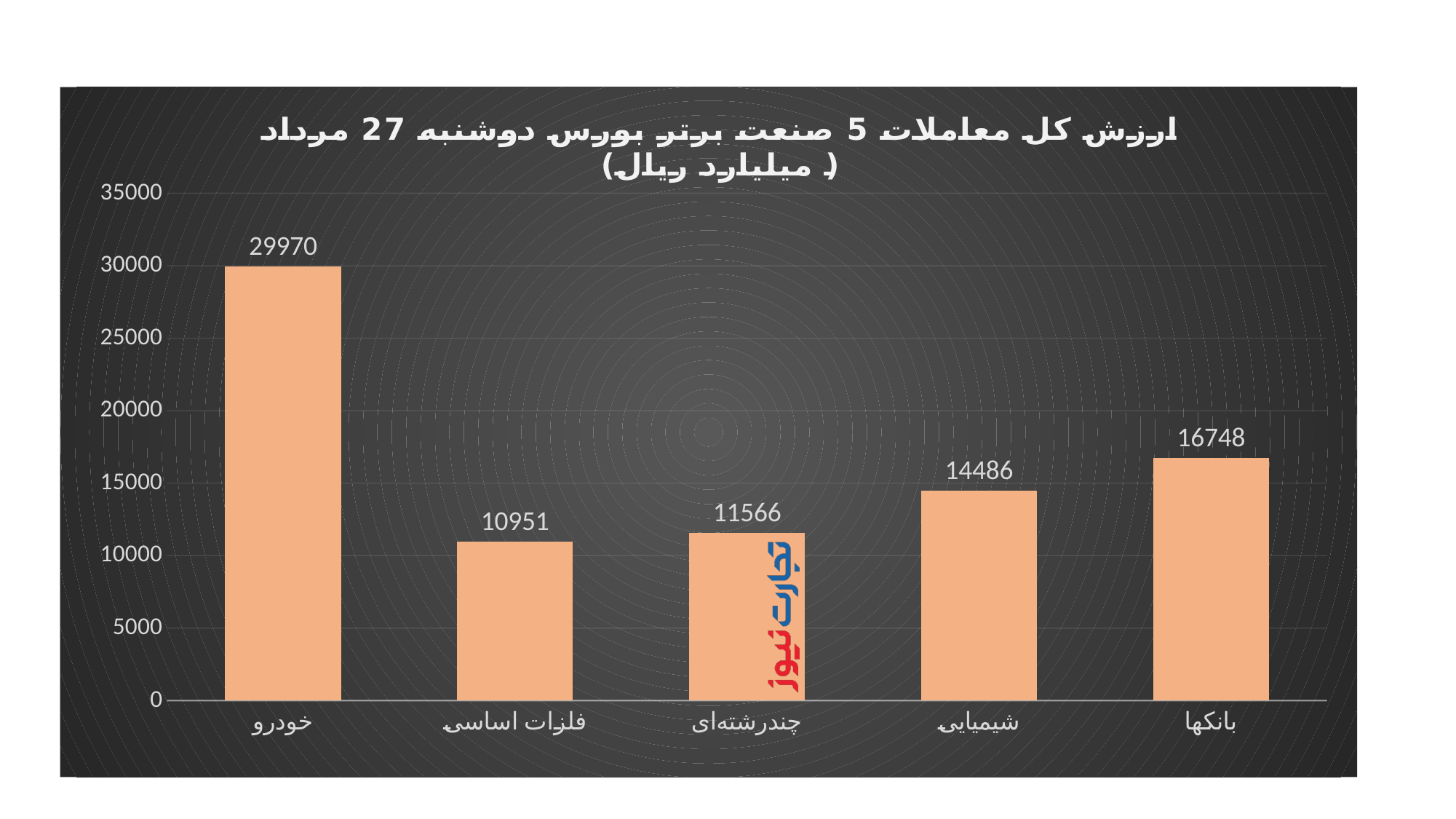
Which is larger, the value for شیمیایی or the value for چندرشته‌ای? شیمیایی Which category has the lowest value? فلزات اساسی How many categories are shown on the x axis? 5 What is the value for فلزات اساسی? 10951 What is the value for بانکها? 16748 What is the difference between the values for چندرشته‌ای and فلزات اساسی? 615 Which category has the highest value? خودرو Is the value for بانکها greater or less than 15000? greater What is the difference between the values for خودرو and بانکها? 13222 What is the value for خودرو? 29970 What is the value for شیمیایی? 14486 What kind of chart is shown on the slide? bar chart